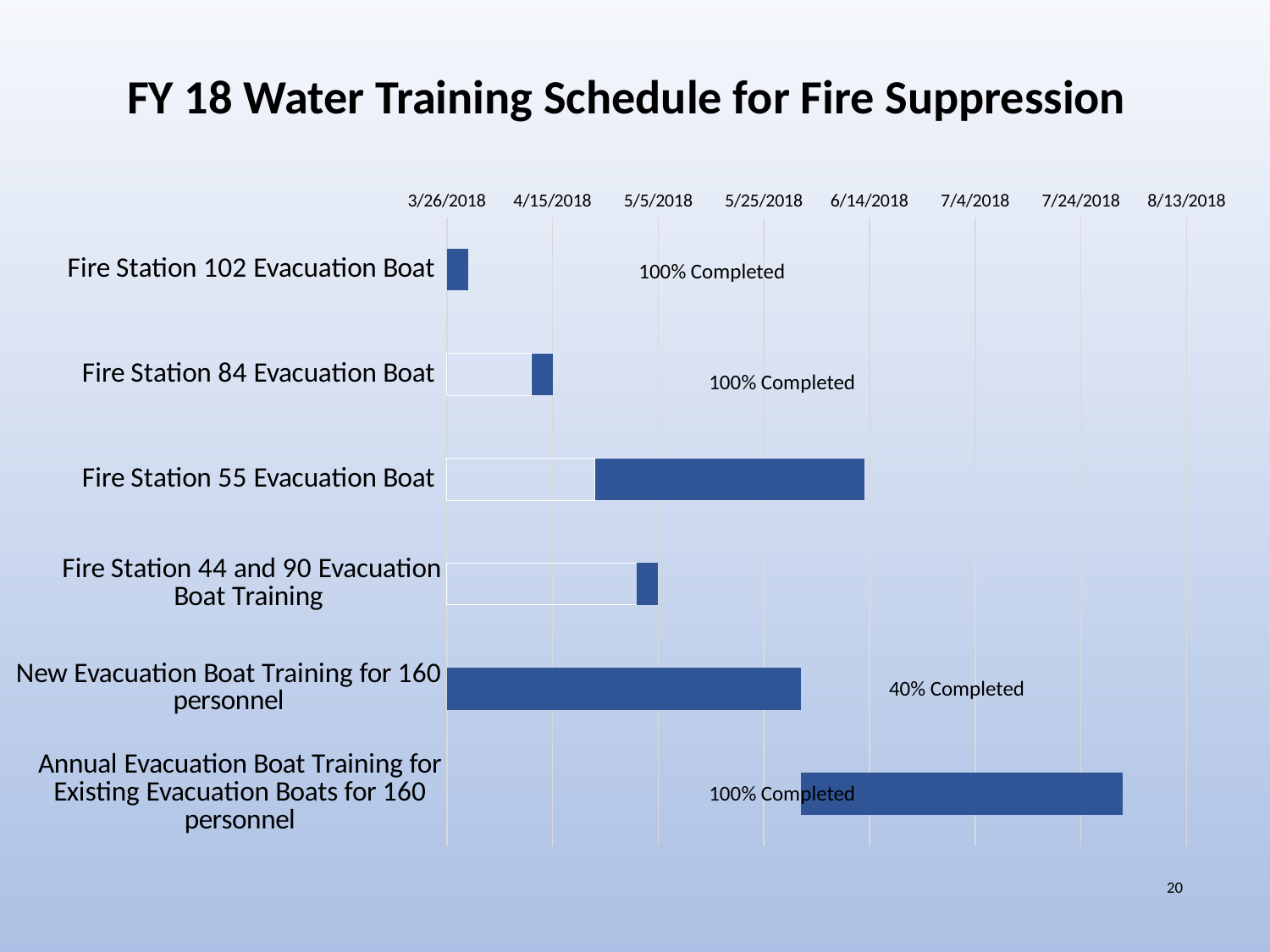
What is the title of the chart? FY 18 Water Training Schedule for Fire Suppression How many tasks on the chart are labeled "100% Completed"? 3 How many tasks (categories) are listed on the chart? 6 Does the bar for New Evacuation Boat Training for 160 personnel end before or after 5/25/2018? after What completion status is shown for Fire Station 102 Evacuation Boat? 100% Completed What completion percentage is shown next to the bar for New Evacuation Boat Training for 160 personnel? 40% Completed Does the bar for Annual Evacuation Boat Training for Existing Evacuation Boats for 160 personnel end before or after 7/24/2018? after Which task's bar ends latest on the date axis? Annual Evacuation Boat Training for Existing Evacuation Boats for 160 personnel What kind of chart is shown on the slide? Bar chart Does the bar for Fire Station 55 Evacuation Boat start before or after 4/15/2018? after Which bar is longer: Fire Station 55 Evacuation Boat or Fire Station 44 and 90 Evacuation Boat Training? Fire Station 55 Evacuation Boat